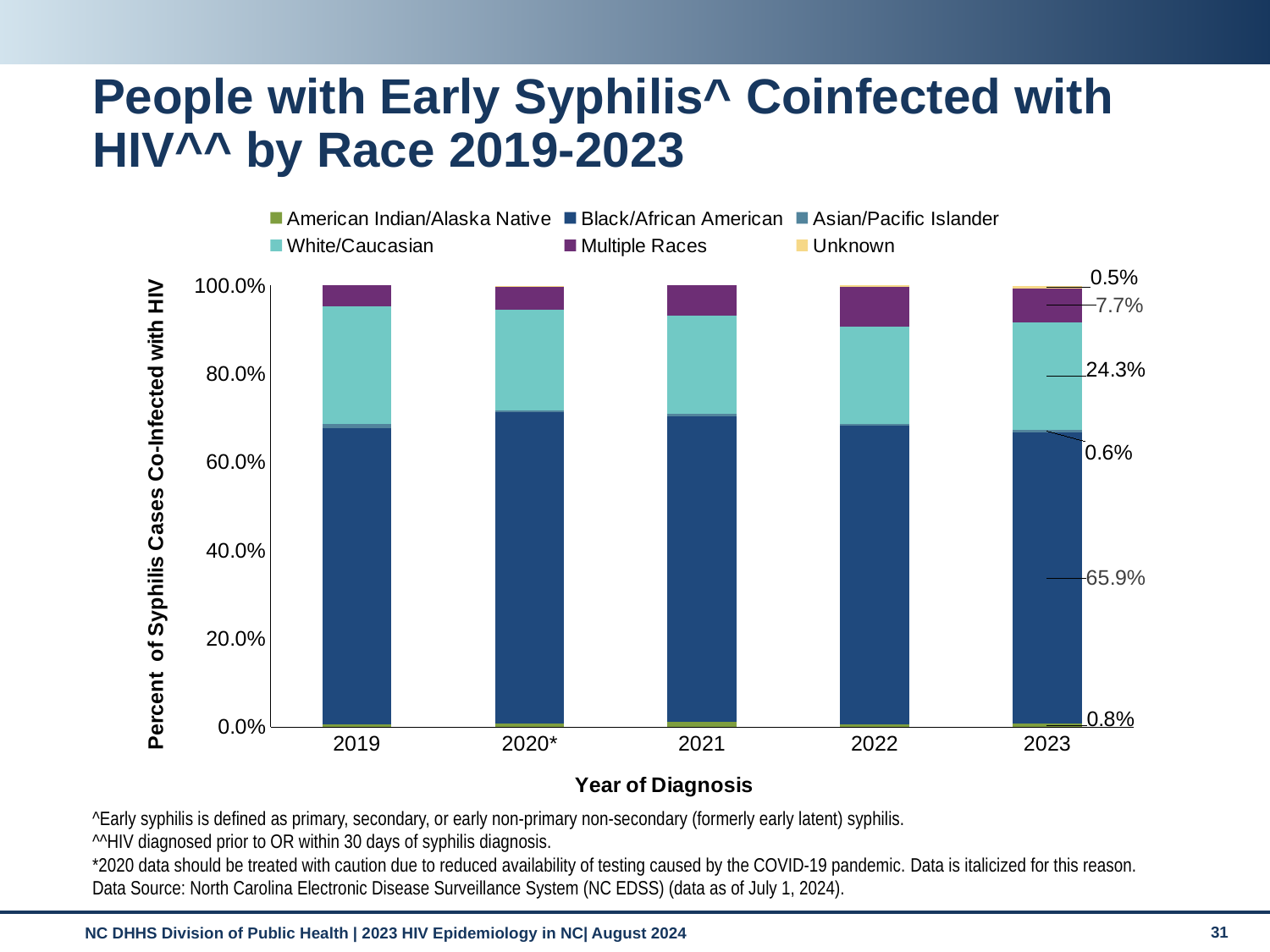
In 2023, how much larger is the Black/African American share than the White/Caucasian share? 41.6 percentage points Is the Black/African American share in 2019 greater or less than 60%? greater What is the Unknown share labeled for 2023? 0.5% What kind of chart is shown on the slide? Stacked bar chart What percentage of the 2023 bar is Black/African American? 65.9% What is the White/Caucasian share shown for 2023? 24.3% What value is labeled for Multiple Races in 2023? 7.7% What is the American Indian/Alaska Native value labeled for 2023? 0.8% How many race categories does the legend list? 6 Which race group has the largest share of the 2023 bar? Black/African American How many years of diagnosis are shown on the x axis? 5 In 2023, which is larger: the White/Caucasian share or the Multiple Races share? White/Caucasian